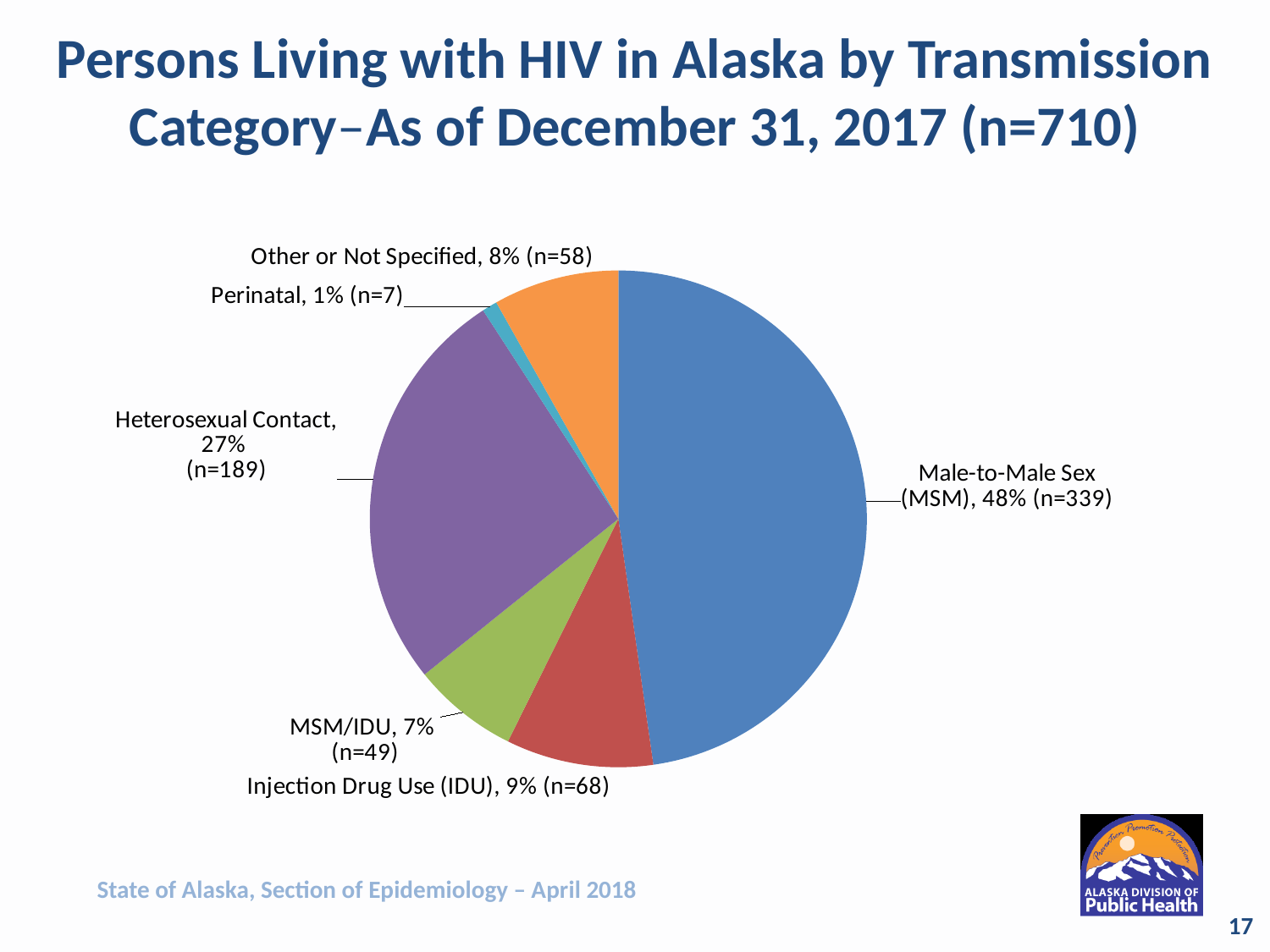
Which transmission category has the largest slice of the pie? Male-to-Male Sex (MSM) How many transmission categories are shown in the pie chart? 6 What percentage of persons living with HIV in Alaska is attributed to Male-to-Male Sex (MSM)? 48% What is the difference in number of persons between Male-to-Male Sex (MSM) and Heterosexual Contact? 150 How many persons are in the Heterosexual Contact category? 189 Which transmission category has the smallest slice of the pie? Perinatal Which category has more persons: Injection Drug Use (IDU) or MSM/IDU? Injection Drug Use (IDU) What type of chart is shown on the slide? pie chart What share of the pie does Injection Drug Use (IDU) represent? 9% What is the total number of persons (n) represented in the chart, as stated in the title? 710 What is the difference in percentage points between Other or Not Specified and MSM/IDU? 1% How many persons are in the Other or Not Specified category? 58